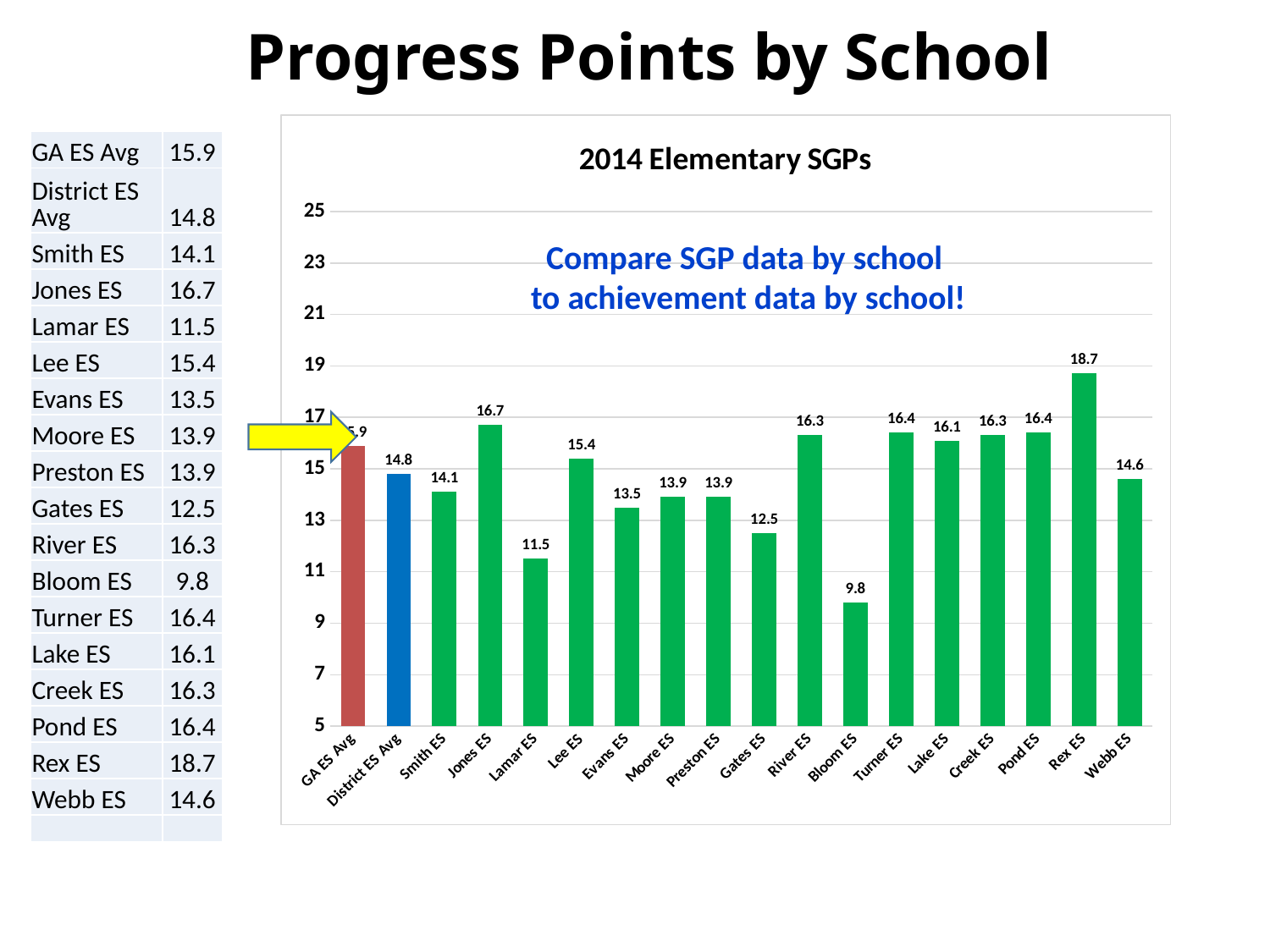
How many bars are plotted in the 2014 Elementary SGPs chart? 18 What is the value for District ES Avg in the 2014 Elementary SGPs chart? 14.8 What colour is the District ES Avg bar in the 2014 Elementary SGPs chart? Blue What is the difference between the GA ES Avg and the District ES Avg in the 2014 Elementary SGPs chart? 1.1 Which school has the highest value in the 2014 Elementary SGPs chart? Rex ES What is the value for Lamar ES in the 2014 Elementary SGPs chart? 11.5 What type of chart is the 2014 Elementary SGPs chart? Bar chart Is the value for Gates ES in the 2014 Elementary SGPs chart greater or less than 13? less Which school has the lowest value in the 2014 Elementary SGPs chart? Bloom ES What is the value for Rex ES in the 2014 Elementary SGPs chart? 18.7 Which has a larger value in the 2014 Elementary SGPs chart, Jones ES or Lee ES? Jones ES What is the difference between the values for Rex ES and Bloom ES in the 2014 Elementary SGPs chart? 8.9